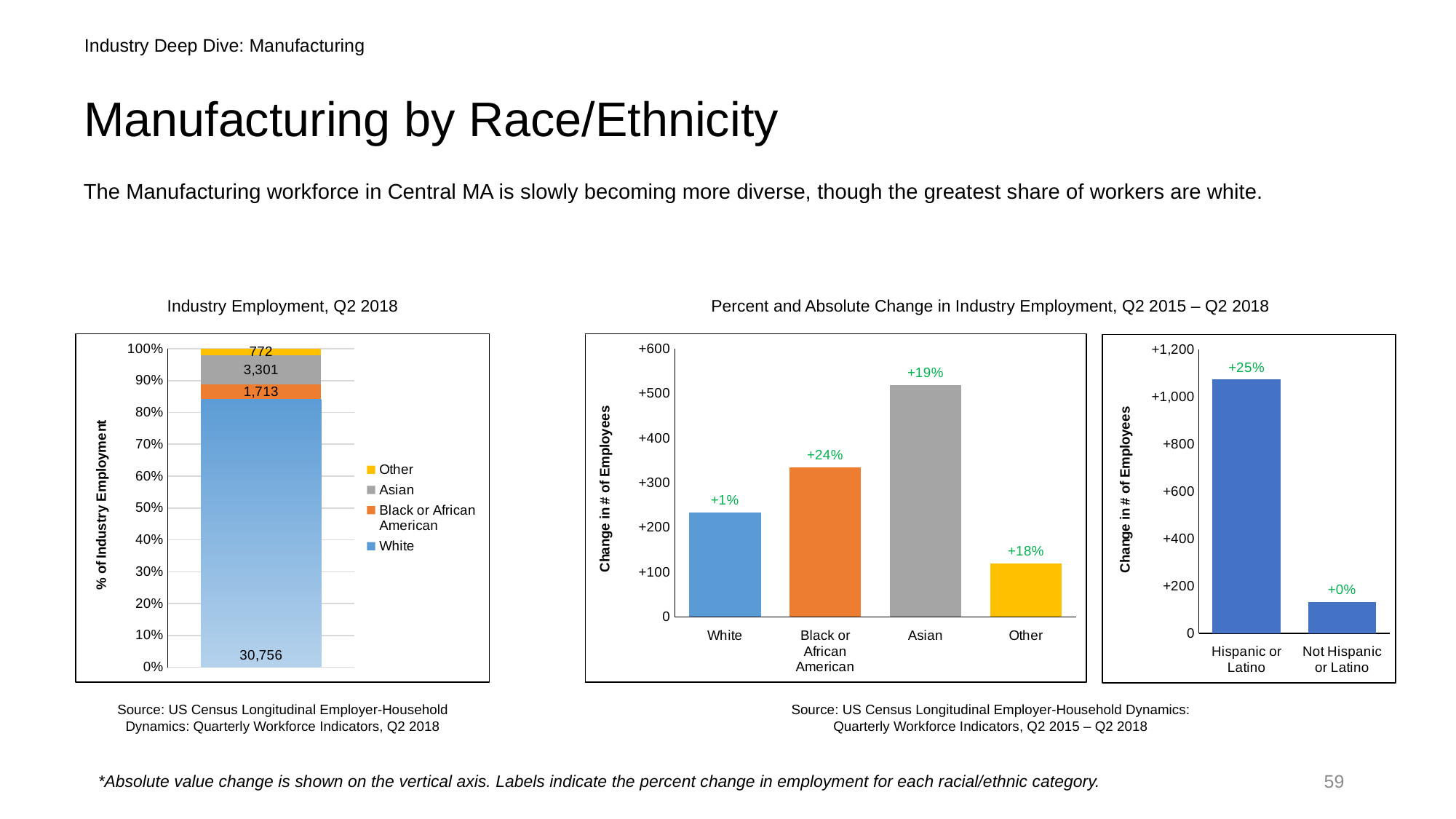
In the middle chart (Percent and Absolute Change in Industry Employment), which category has the tallest bar? Asian In the middle chart (Percent and Absolute Change in Industry Employment), is the bar for White greater or less than +300? less In the middle chart (Percent and Absolute Change in Industry Employment), how many categories are plotted on the x axis? 4 In the Industry Employment, Q2 2018 chart, what is the difference between the Asian and Black or African American values? 1,588 In the Industry Employment, Q2 2018 chart, how many White employees are shown? 30,756 What kind of chart is the right-hand chart showing Hispanic or Latino and Not Hispanic or Latino? bar chart In the right-hand chart, what percent change label is shown for Hispanic or Latino? +25% How many series does the legend of the Industry Employment, Q2 2018 chart list? 4 In the right-hand chart, is the bar for Not Hispanic or Latino greater or less than +200? less In the Industry Employment, Q2 2018 chart, what is the value for Asian employees? 3,301 In the Industry Employment, Q2 2018 chart, what is the total of the stacked bar across all four groups? 36,542 In the middle chart (Percent and Absolute Change in Industry Employment), what percent change label is shown for Black or African American? +24%